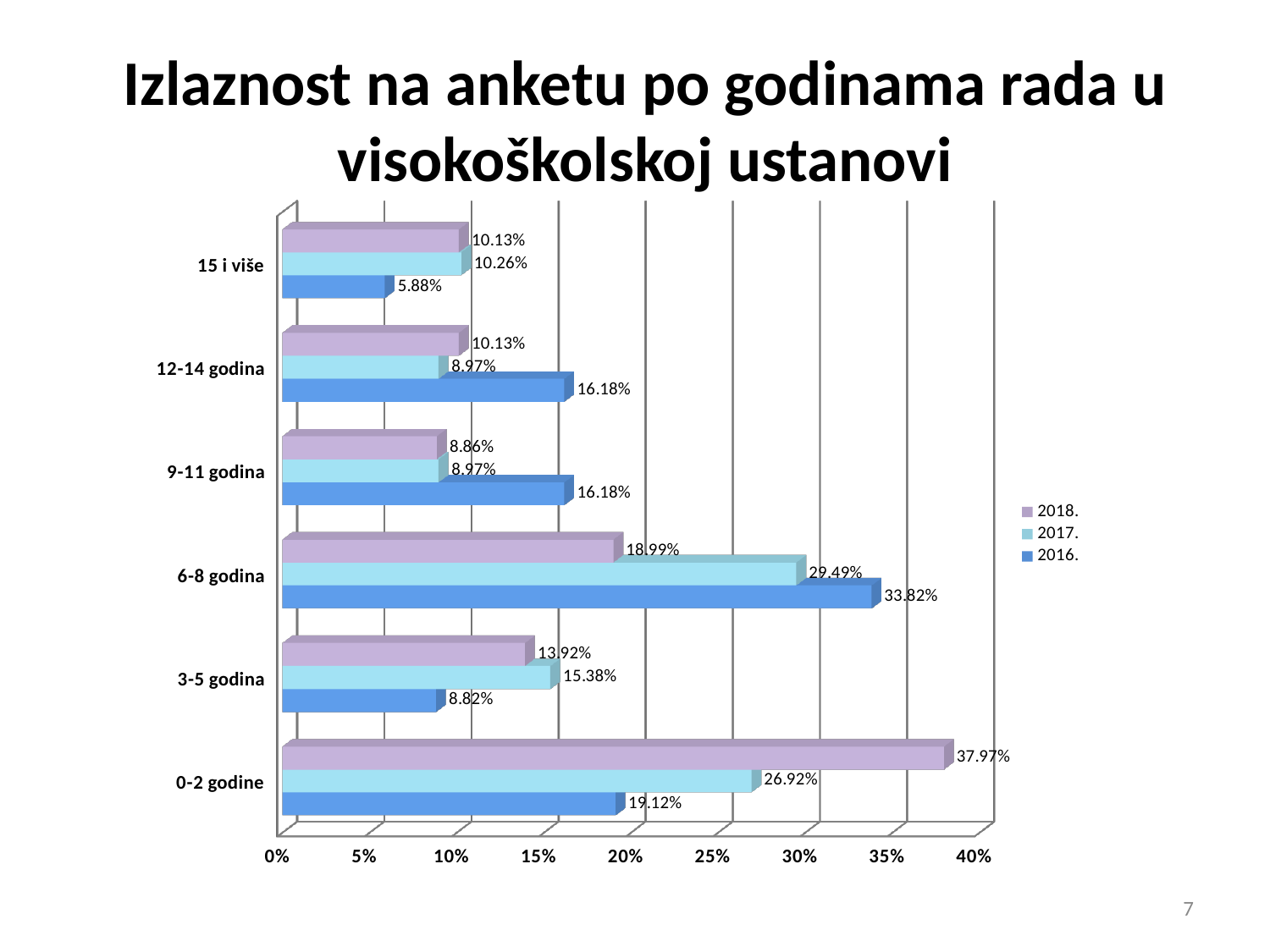
What kind of chart is shown on the slide? bar chart What is the value for 0-2 godine in the 2018. series? 37.97% Which is larger for 3-5 godina: the 2017. value or the 2016. value? 2017. Which category has the highest value in the 2016. series? 6-8 godina What is the difference between the 2018. and 2016. values for 0-2 godine? 18.85% How many series does the legend list? 3 How many categories are shown on the y axis? 6 What is the value for 6-8 godina in the 2016. series? 33.82% Which category has the lowest value in the 2016. series? 15 i više What is the title of the chart? Izlaznost na anketu po godinama rada u visokoškolskoj ustanovi Which category has the highest value in the 2018. series? 0-2 godine What is the value for 15 i više in the 2017. series? 10.26%